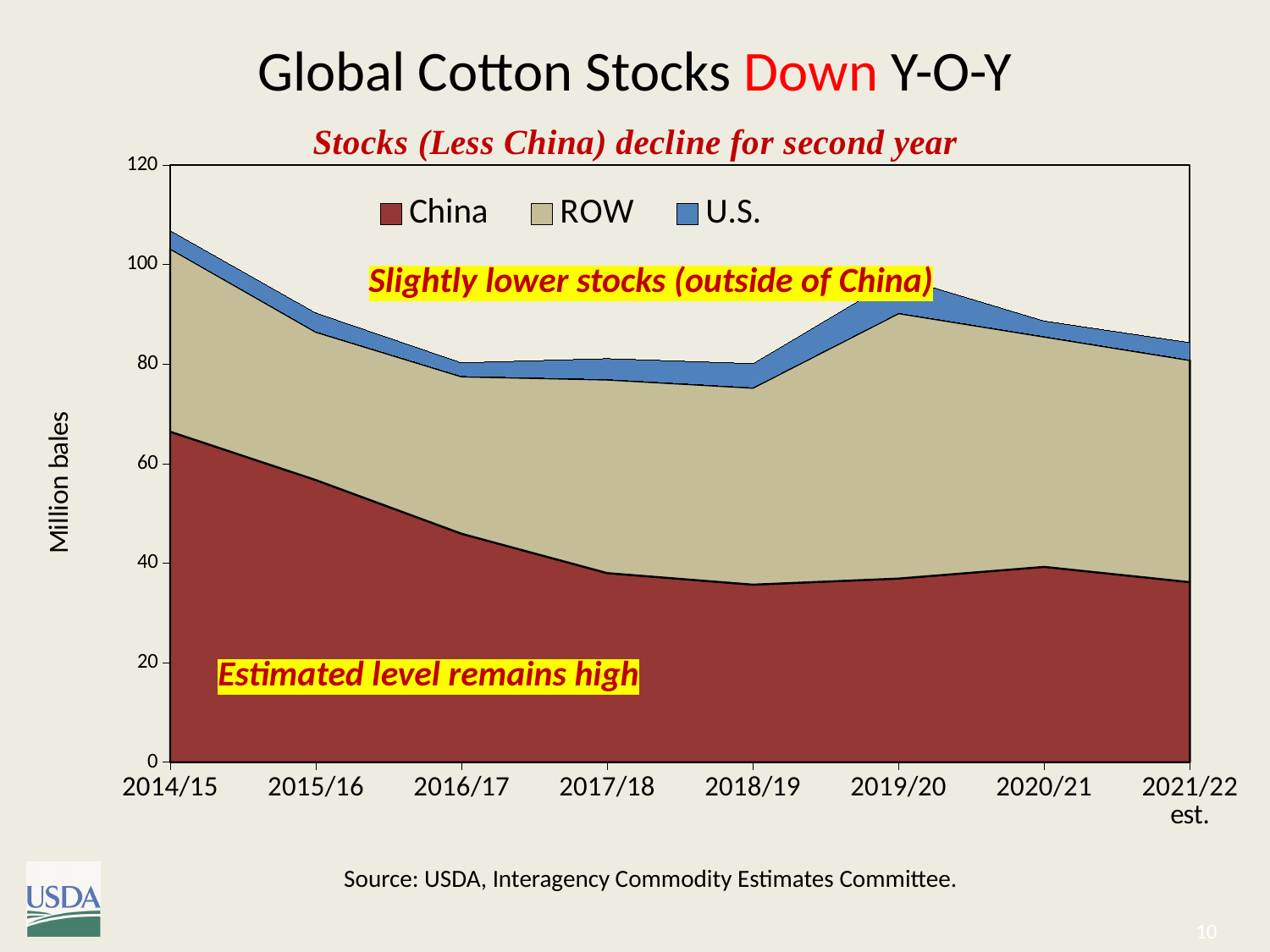
In which year is the China series at its highest? 2014/15 How many marketing years are shown along the x axis? 8 Is the value for China in 2018/19 greater or less than 40? less Is the total stacked value in 2014/15 greater or less than 100? greater Which series is shown in red at the bottom of the stack? China Is the total stacked value in 2019/20 greater or less than 100? less How many series does the legend list? 3 What kind of chart is shown on the slide? Stacked area chart What is the label on the vertical axis? Million bales Does the China series rise or fall from 2014/15 to 2017/18? fall In which year is the total stacked value (China + ROW + U.S.) highest? 2014/15